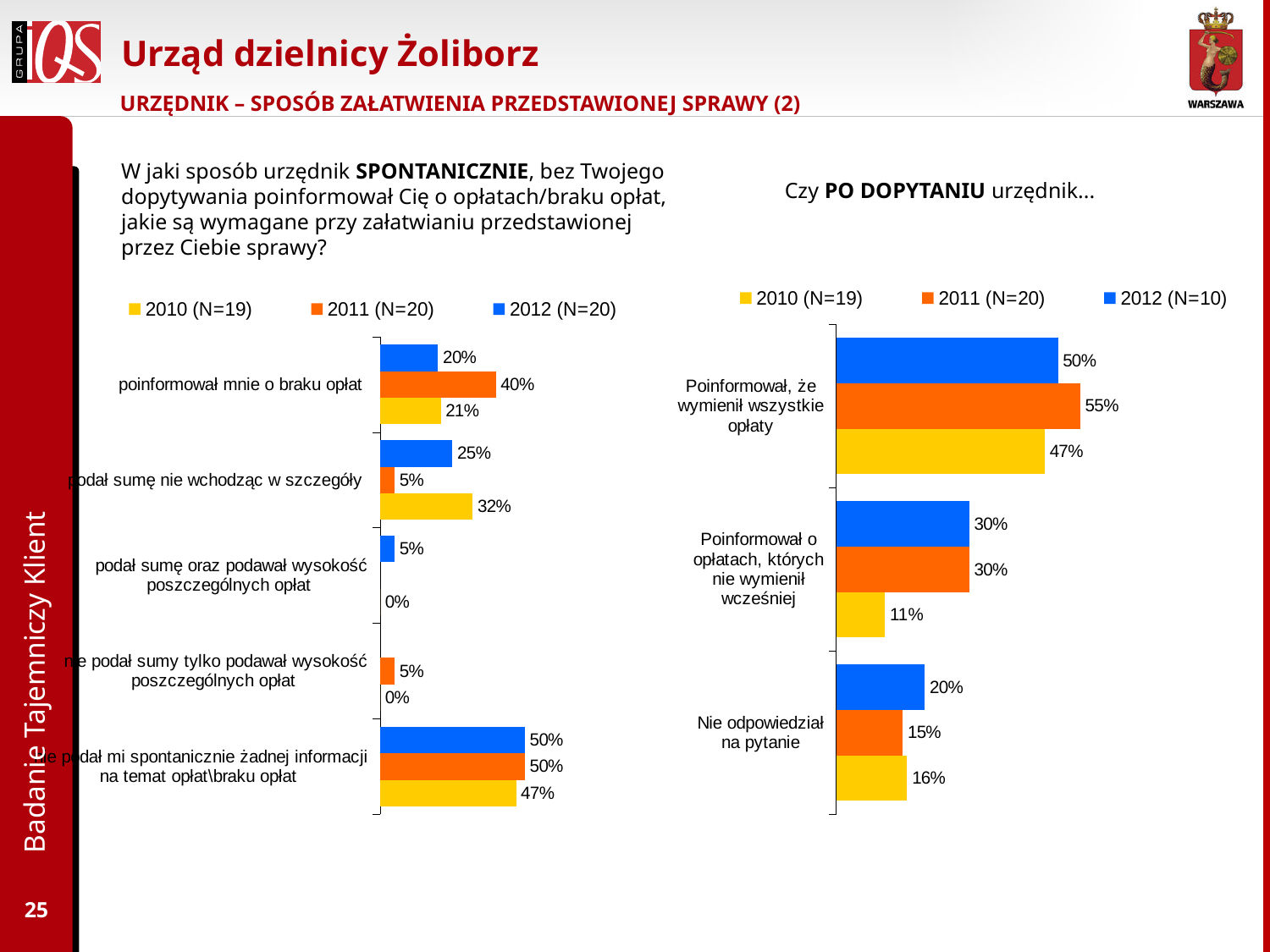
What sample size (N) is given for 2012 in the legend of the right chart? N=10 In the right chart, what is the 2010 value for 'Poinformował o opłatach, których nie wymienił wcześniej'? 11% In the left chart, what is the difference between the 2011 and 2010 values for 'poinformował mnie o braku opłat'? 19 percentage points How many categories are shown in the right chart? 3 In the left chart (spontaneous information about fees), what is the 2011 value for 'poinformował mnie o braku opłat'? 40% In the left chart, which is larger for 'podał sumę nie wchodząc w szczegóły': the 2012 value or the 2011 value? 2012 In the right chart, which year has the highest value for 'Poinformował, że wymienił wszystkie opłaty'? 2011 In the right chart ('Czy PO DOPYTANIU urzędnik...'), what is the 2011 value for 'Poinformował, że wymienił wszystkie opłaty'? 55% In the right chart, what is the difference between the 2012 and 2011 values for 'Nie odpowiedział na pytanie'? 5 percentage points In the left chart, what is the 2010 value for 'podał sumę nie wchodząc w szczegóły'? 32% How many series does the legend of the left chart list? 3 In the left chart, what is the 2012 value for 'nie podał mi spontanicznie żadnej informacji na temat opłat\braku opłat'? 50%